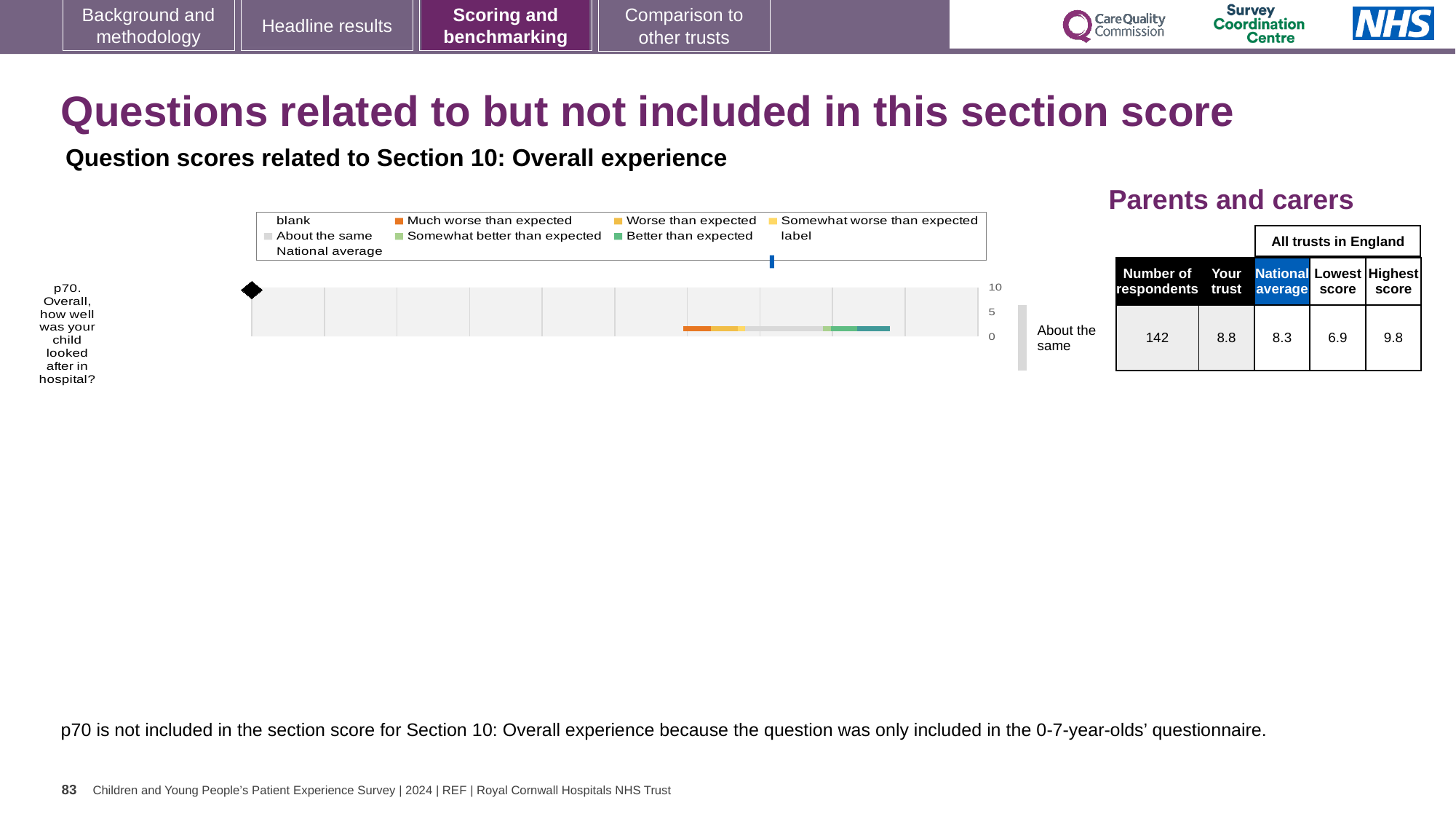
How many respondents answered question p70? 142 What is the 'Your trust' score for question p70 (Overall, how well was your child looked after in hospital?)? 8.8 Which is higher for p70: the trust's score or the national average? Your trust Which benchmark category is the trust's p70 result placed in? About the same How many questions are plotted on the chart? 1 What is the difference between the highest and lowest trust scores for p70? 2.9 What kind of chart is used to show the p70 benchmark result? Bar chart What is the national average score for question p70? 8.3 What is the lowest score among all trusts in England for question p70? 6.9 By how much does the trust's score for p70 exceed the national average? 0.5 Which respondent group does the chart on this slide relate to? Parents and carers What is the highest score among all trusts in England for question p70? 9.8